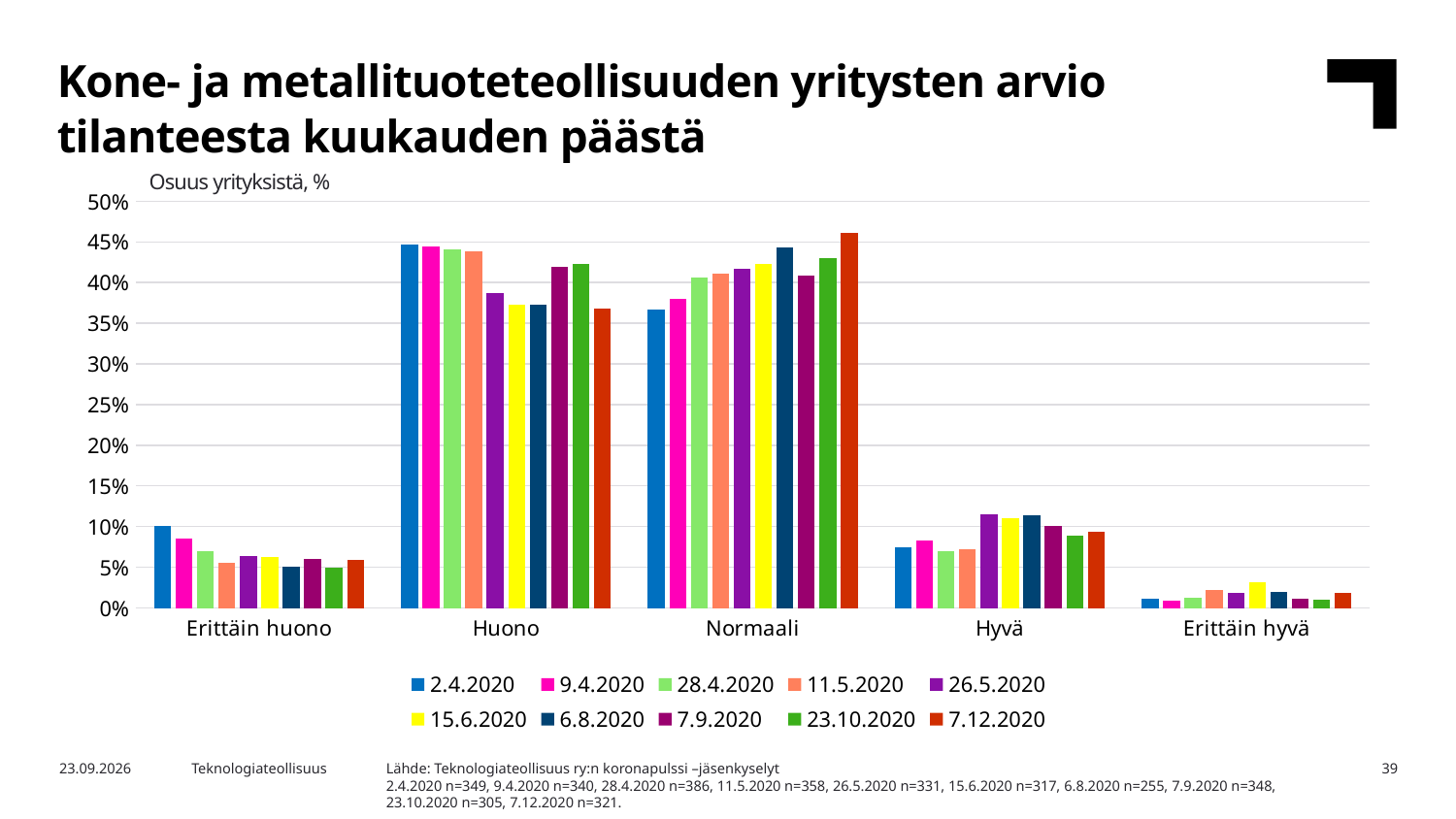
Is the value for 7.12.2020 in the Huono category greater or less than 40%? less For the 7.12.2020 series, which category has the highest value? Normaali What kind of chart is shown on the slide? Bar chart How many categories are shown on the x axis? 5 Is the value for 2.4.2020 in the Huono category greater or less than 40%? greater For the 2.4.2020 series, which category has the lowest value? Erittäin hyvä Is the value for 7.12.2020 in the Normaali category greater or less than 40%? greater For the 2.4.2020 series, which category has the highest value? Huono How many series does the legend list? 10 What is the label shown above the vertical axis? Osuus yrityksistä, % In the Normaali category, which is larger: the value for 2.4.2020 or for 7.12.2020? 7.12.2020